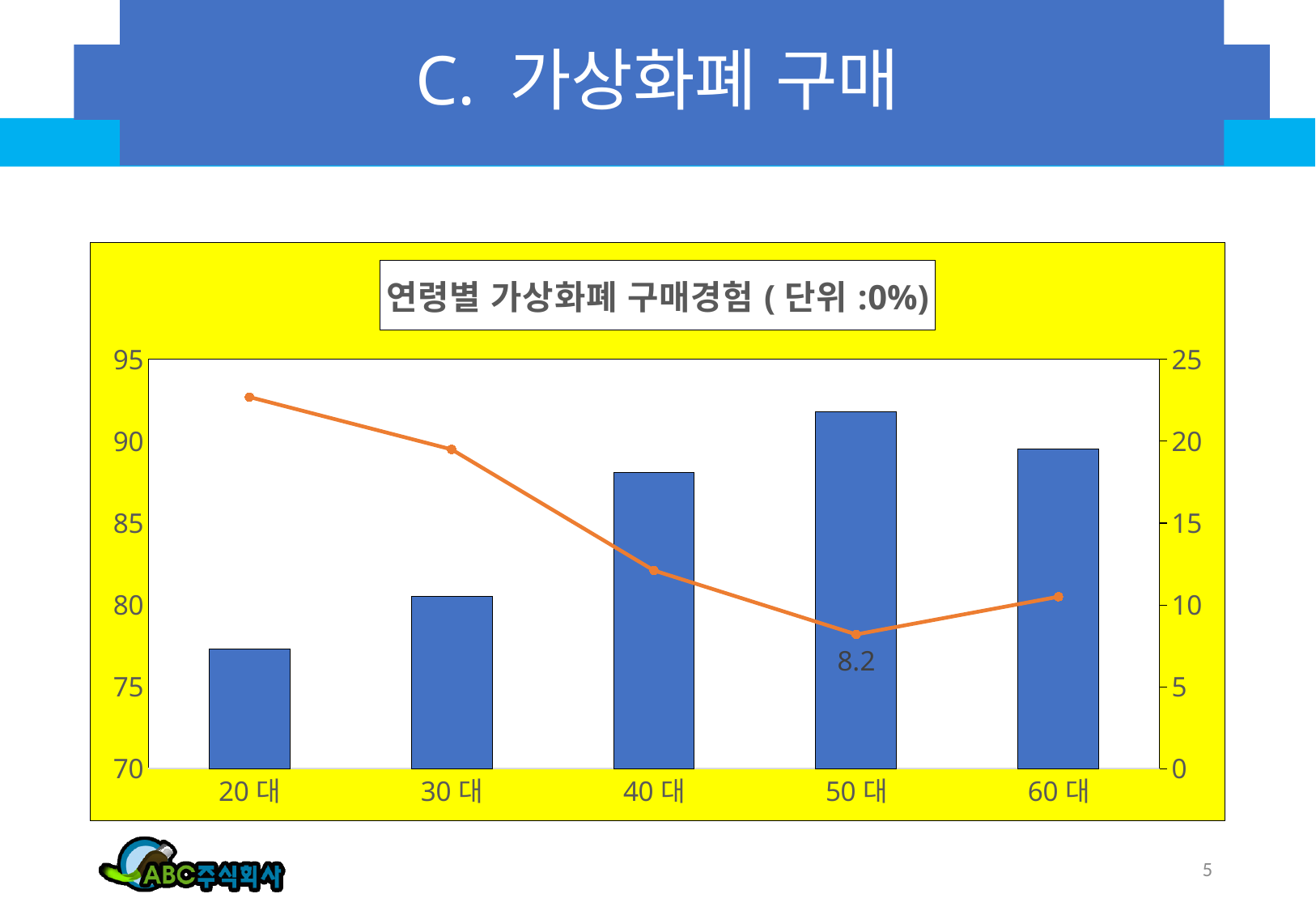
Is the blue bar for 50 대 greater or less than 90 on the left axis? greater Which age group has the tallest blue bar? 50 대 How many age-group categories are shown on the x axis? 5 What kind of chart is shown on the slide? A combination bar and line chart Which blue bar is taller, 30 대 or 40 대? 40 대 At which age group is the orange line at its lowest point? 50 대 Which age group has the shortest blue bar? 20 대 Does the orange line rise or fall from 20 대 to 50 대? It falls At which age group is the orange line at its highest point? 20 대 What is the value of the orange line at 50 대? 8.2 Is the orange line value for 20 대 greater or less than 20 on the right axis? greater Is the blue bar for 20 대 greater or less than 80 on the left axis? less